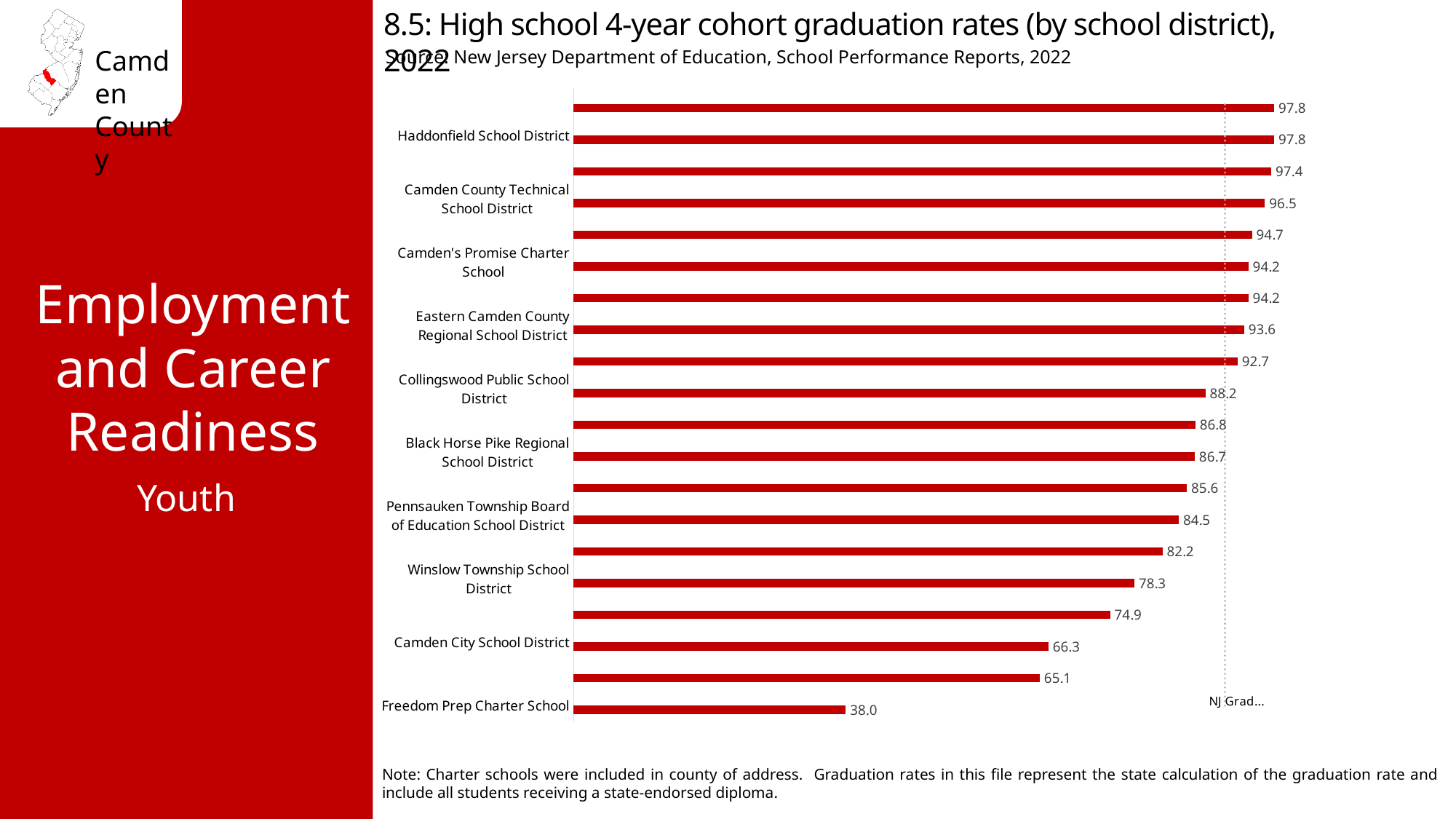
What is the graduation rate for Freedom Prep Charter School? 38.0 What type of chart is shown on the slide? Bar chart What is the graduation rate for Camden City School District? 66.3 What is the source cited for the chart data? New Jersey Department of Education, School Performance Reports, 2022 Which has a higher graduation rate, Camden County Technical School District or Pennsauken Township Board of Education School District? Camden County Technical School District What is the graduation rate for Camden County Technical School District? 96.5 How many bars are plotted on the chart? 20 What is the graduation rate for Haddonfield School District? 97.8 What is the difference between the graduation rates of Haddonfield School District and Freedom Prep Charter School? 59.8 What is the graduation rate for Winslow Township School District? 78.3 What is the highest graduation rate value shown on the chart? 97.8 Which school district has the lowest graduation rate on the chart? Freedom Prep Charter School